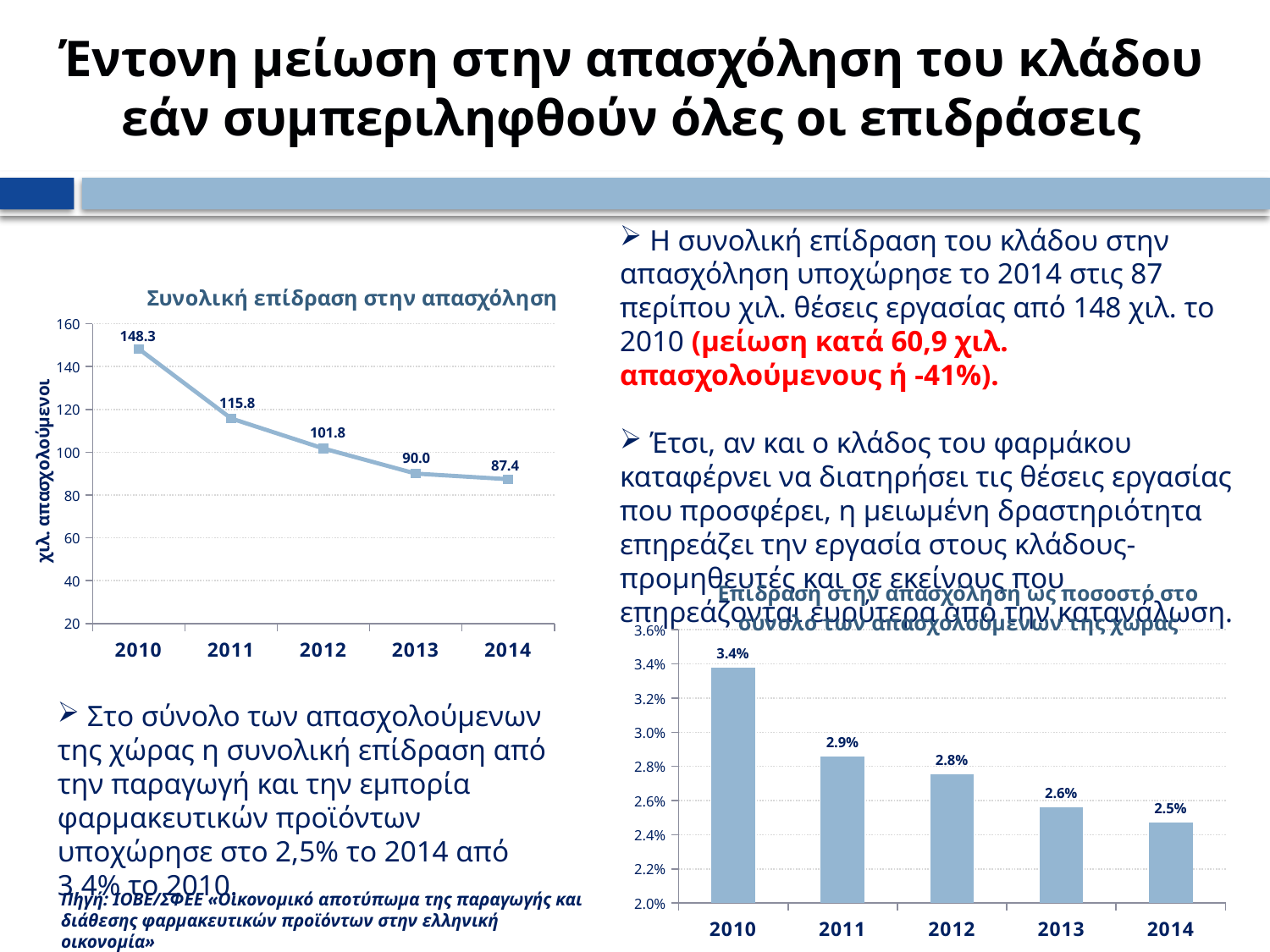
In the bar chart on the lower right, what is the value for 2013? 2.6% In the line chart titled 'Συνολική επίδραση στην απασχόληση', what is the value for 2014? 87.4 In the bar chart on the lower right, which year has the highest value? 2010 What kind of chart is the one on the left titled 'Συνολική επίδραση στην απασχόληση'? line chart In the line chart titled 'Συνολική επίδραση στην απασχόληση', do the values rise or fall from 2010 to 2014? fall In the bar chart on the lower right, what is the value for 2011? 2.9% In the line chart titled 'Συνολική επίδραση στην απασχόληση', which year has the lowest value? 2014 In the bar chart on the lower right, what is the difference between the 2010 and 2014 values? 0.9% In the line chart titled 'Συνολική επίδραση στην απασχόληση', what is the value for 2010? 148.3 In the line chart titled 'Συνολική επίδραση στην απασχόληση', what is the difference between the 2010 and 2014 values? 60.9 What kind of chart is the one on the lower right of the slide? bar chart How many years are shown on the x axis of the bar chart on the lower right? 5